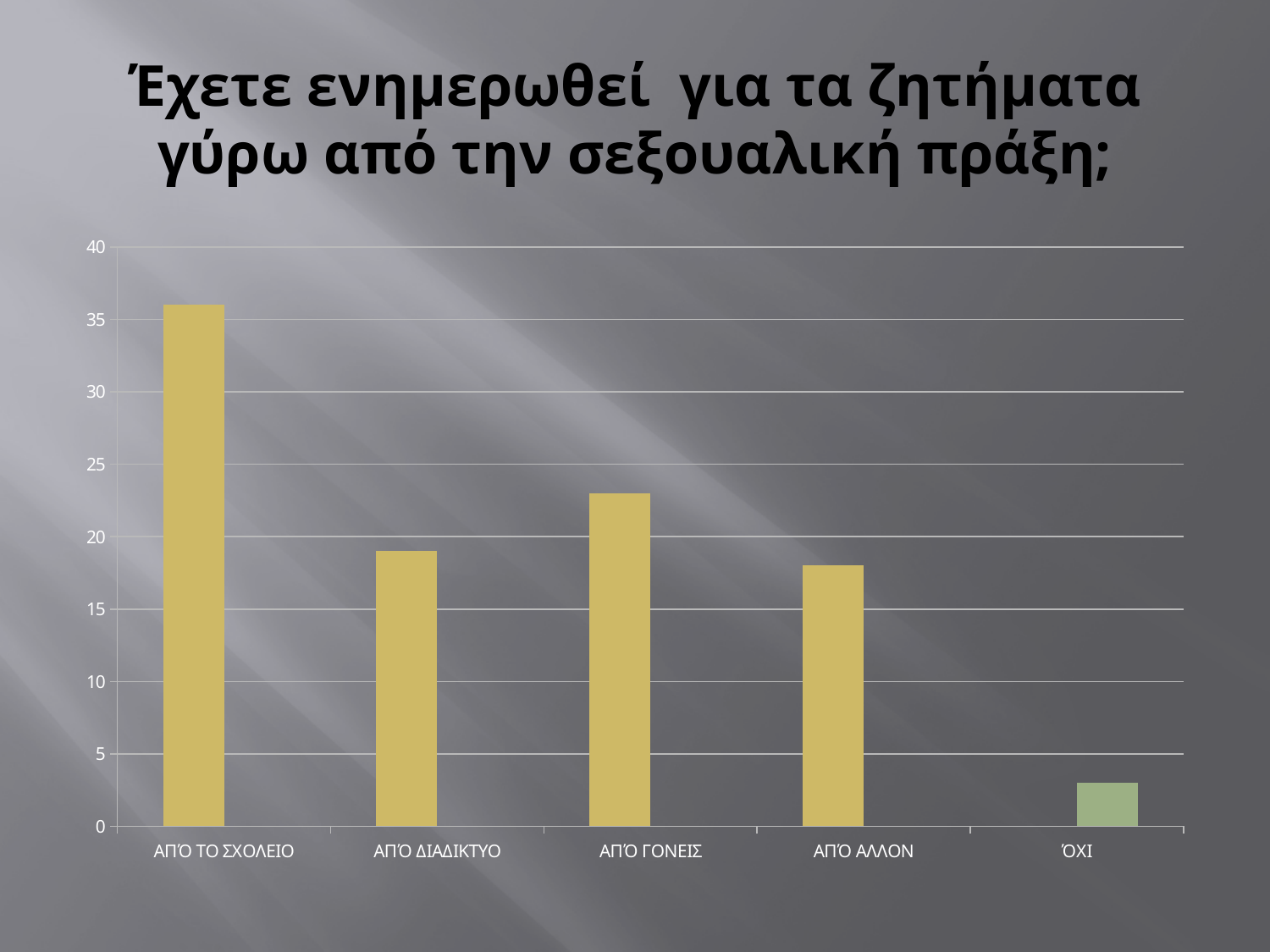
What kind of chart is shown on the slide? bar chart Is the value for ΑΠΌ ΓΟΝΕΙΣ greater or less than 20? greater Which category has the lowest bar? ΌΧΙ How many bars are plotted in the chart? 5 Is the value for ΌΧΙ greater or less than 5? less Is the value for ΑΠΌ ΤΟ ΣΧΟΛΕΙΟ greater or less than 35? greater Which category has the highest bar? ΑΠΌ ΤΟ ΣΧΟΛΕΙΟ What is the highest value shown on the vertical axis? 40 Which is larger, the value for ΑΠΌ ΓΟΝΕΙΣ or the value for ΑΠΌ ΔΙΑΔΙΚΤΥΟ? ΑΠΌ ΓΟΝΕΙΣ Which is larger, the value for ΑΠΌ ΤΟ ΣΧΟΛΕΙΟ or the value for ΑΠΌ ΓΟΝΕΙΣ? ΑΠΌ ΤΟ ΣΧΟΛΕΙΟ